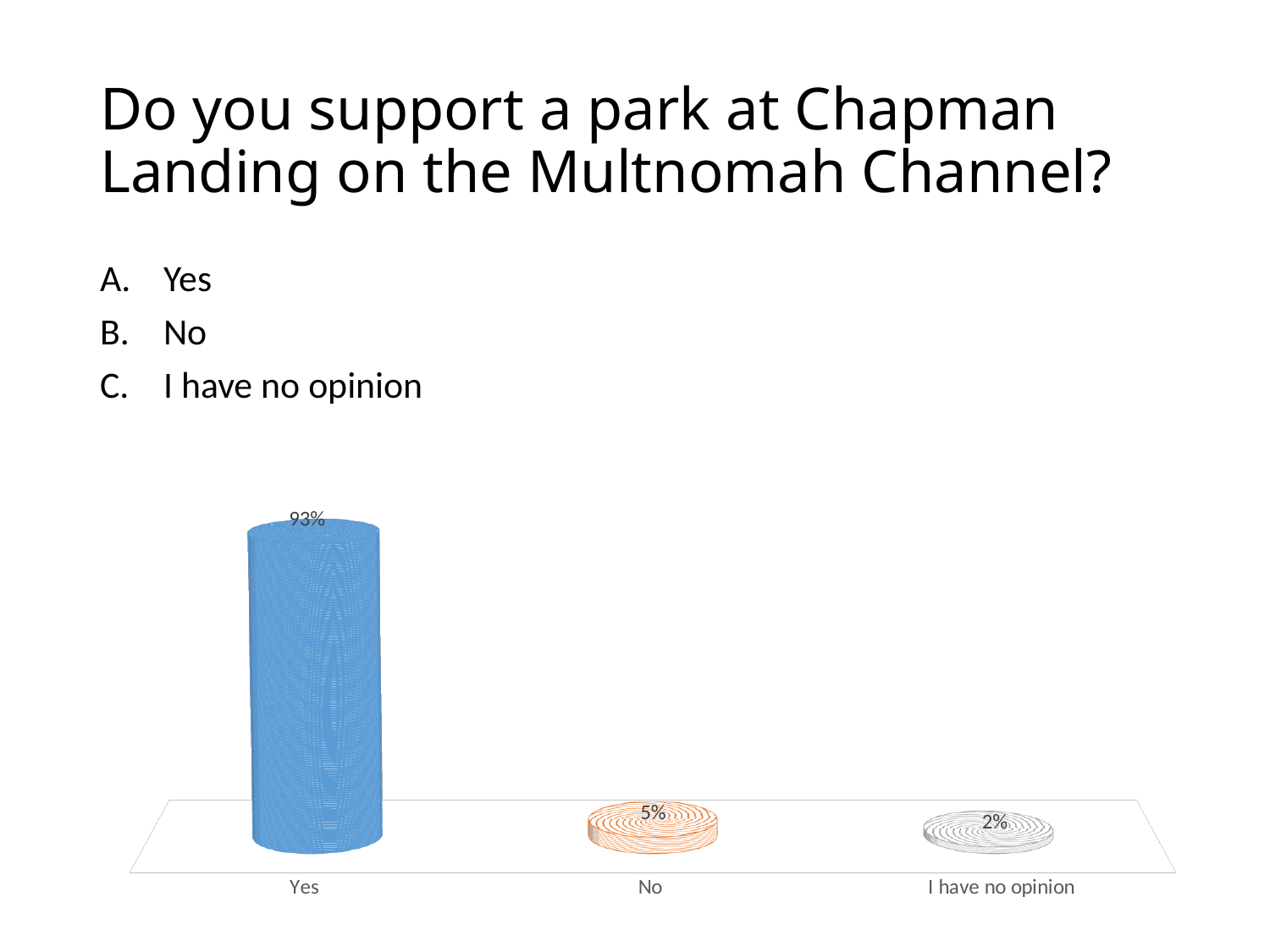
What kind of chart is shown on the slide? Bar chart How many response categories are shown in the chart? 3 Which is larger, the value for "No" or the value for "I have no opinion"? No What is the difference between the "Yes" and "No" percentages? 88% Which response category has the lowest value? I have no opinion What percentage of respondents answered "No"? 5% What percentage of respondents answered "I have no opinion"? 2% What percentage of respondents answered "Yes"? 93% Which response category has the highest value? Yes What is the difference between the "No" and "I have no opinion" percentages? 3% What colour is the bar for "Yes"? Blue Do the values rise or fall moving from left to right across the categories? Fall